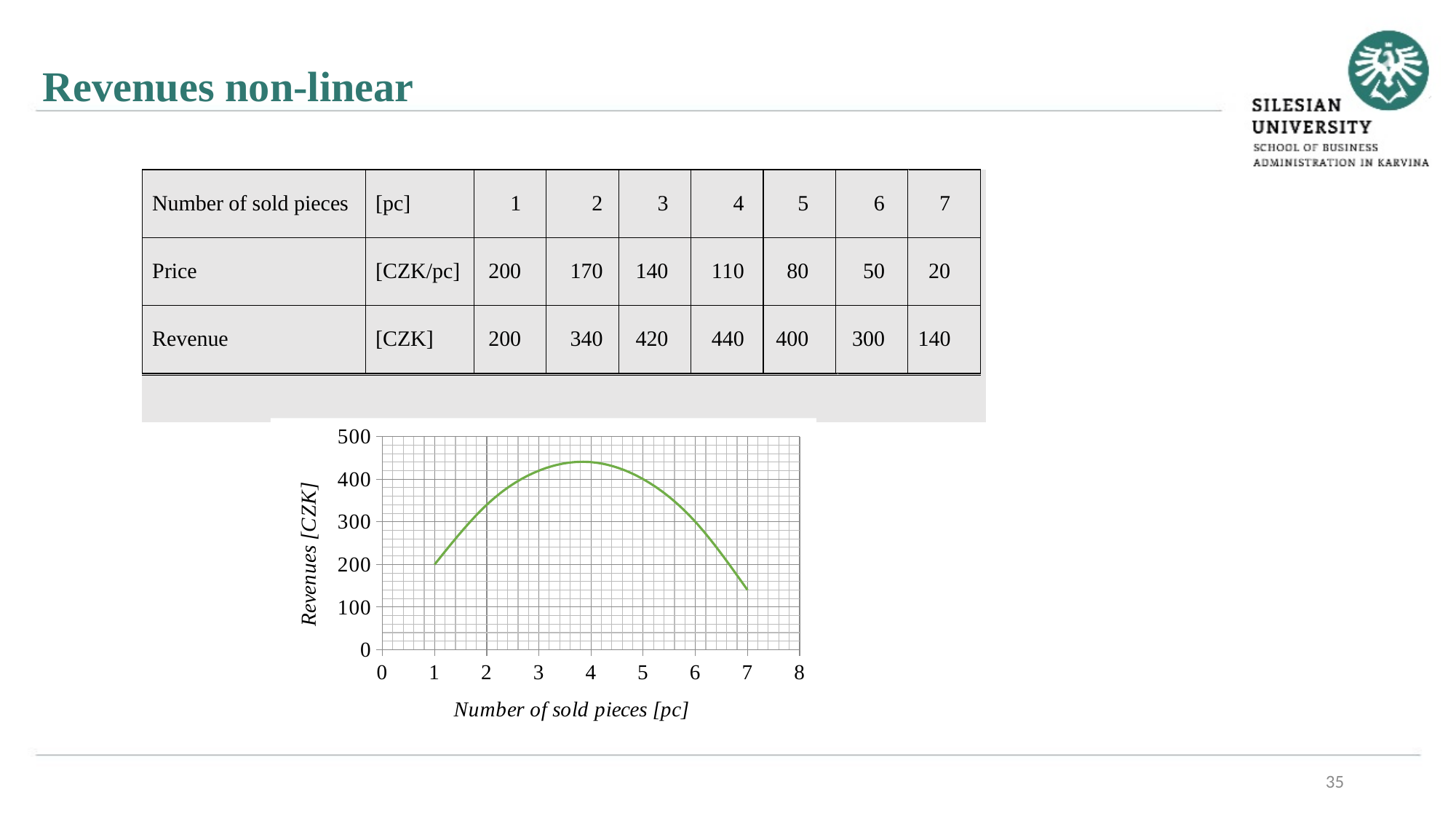
What is the title of the x axis of the chart? Number of sold pieces [pc] At which number of sold pieces does the revenue curve reach its highest point? 4 Which is larger, the revenue at 2 sold pieces or the revenue at 7 sold pieces? 2 sold pieces What is the revenue plotted at 6 sold pieces? 300 Is the revenue at 3 sold pieces greater or less than 400? greater What is the revenue plotted at 5 sold pieces? 400 How does the revenue change as the number of sold pieces increases from 1 to 7? rises to a peak at 4, then falls At which number of sold pieces is the plotted revenue lowest? 7 Is the revenue at 7 sold pieces greater or less than 200? less What is the title of the y axis of the chart? Revenues [CZK] What kind of chart is shown on the slide? line chart What is the revenue plotted at 1 sold piece? 200